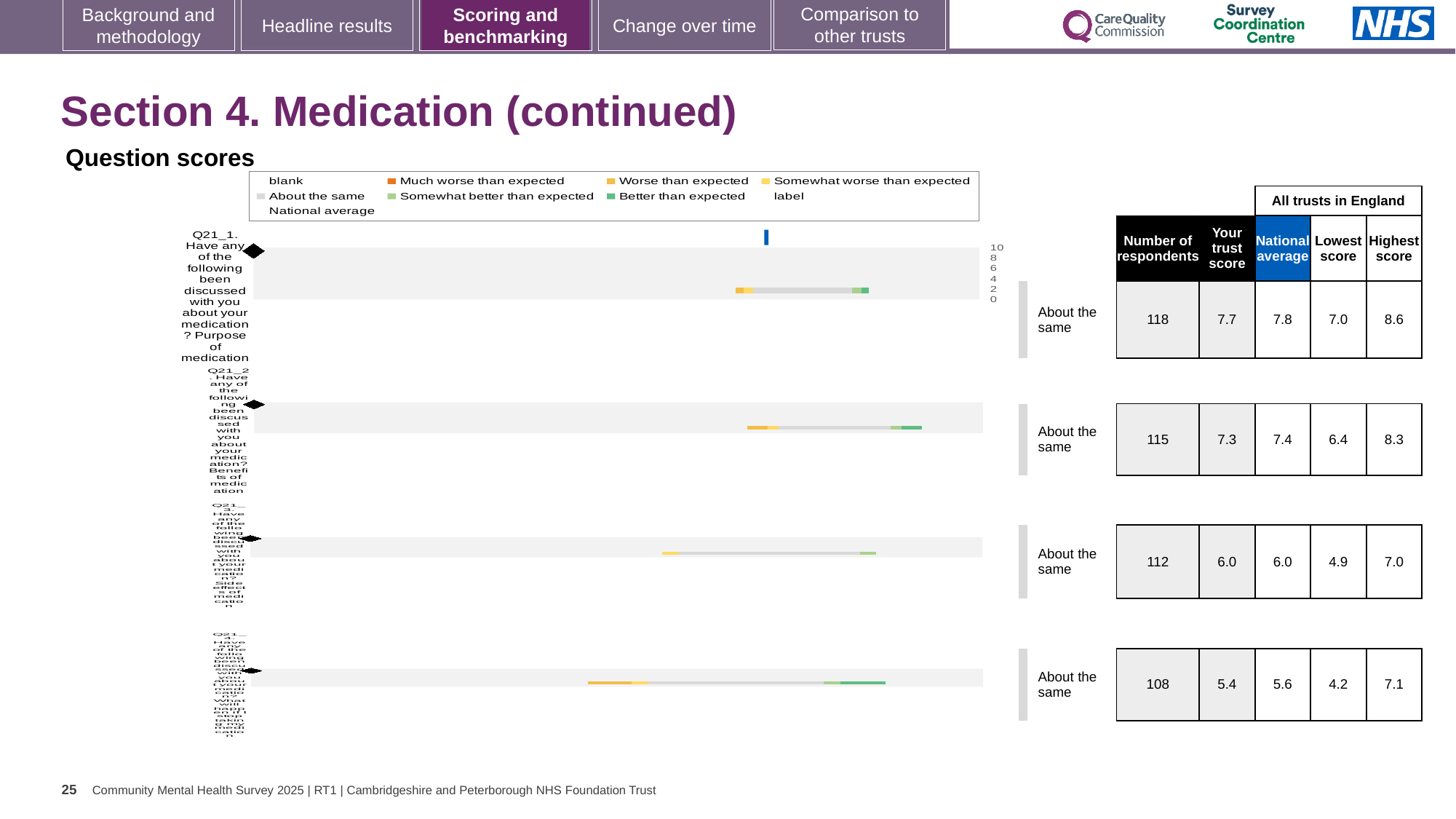
Which legend entry is shown in dark orange? Much worse than expected How many question bars (Q21_1 to Q21_4) are plotted in the chart? 4 What is the highest tick value shown on the chart's score axis? 10 What is the label of the first (topmost) bar in the chart? Q21_1. Have any of the following been discussed with you about your medication? Purpose of medication What kind of chart is shown under the heading 'Question scores'? bar chart How many entries does the chart's legend list? 9